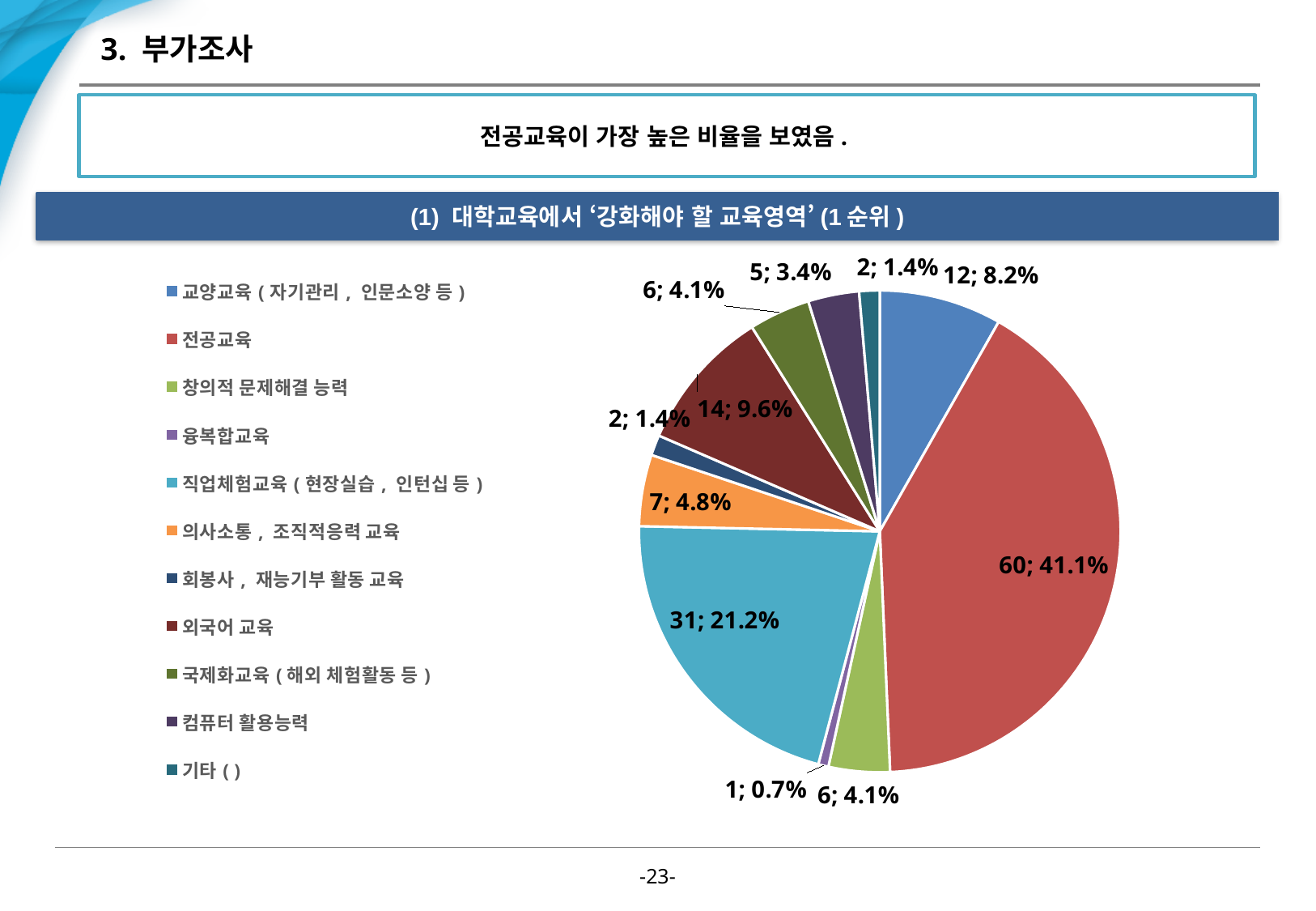
How many categories does the legend of the pie chart list? 11 Which category has the largest slice of the pie? 전공교육 What is the difference in count between 전공교육 and 직업체험교육 (현장실습, 인턴십 등)? 29 What is the count and share shown for 외국어 교육? 14; 9.6% What share of the pie does 컴퓨터 활용능력 take? 3.4% Which is larger, the slice for 의사소통, 조직적응력 교육 or the slice for 외국어 교육? 외국어 교육 What is the title of the chart section on the slide? (1) 대학교육에서 '강화해야 할 교육영역' (1순위) What is the count and share shown for 교양교육 (자기관리, 인문소양 등)? 12; 8.2% Which category has the smallest slice of the pie? 융복합교육 What is the count and share shown for 전공교육? 60; 41.1% What is the count and share shown for 직업체험교육 (현장실습, 인턴십 등)? 31; 21.2% What type of chart is shown on the slide? pie chart